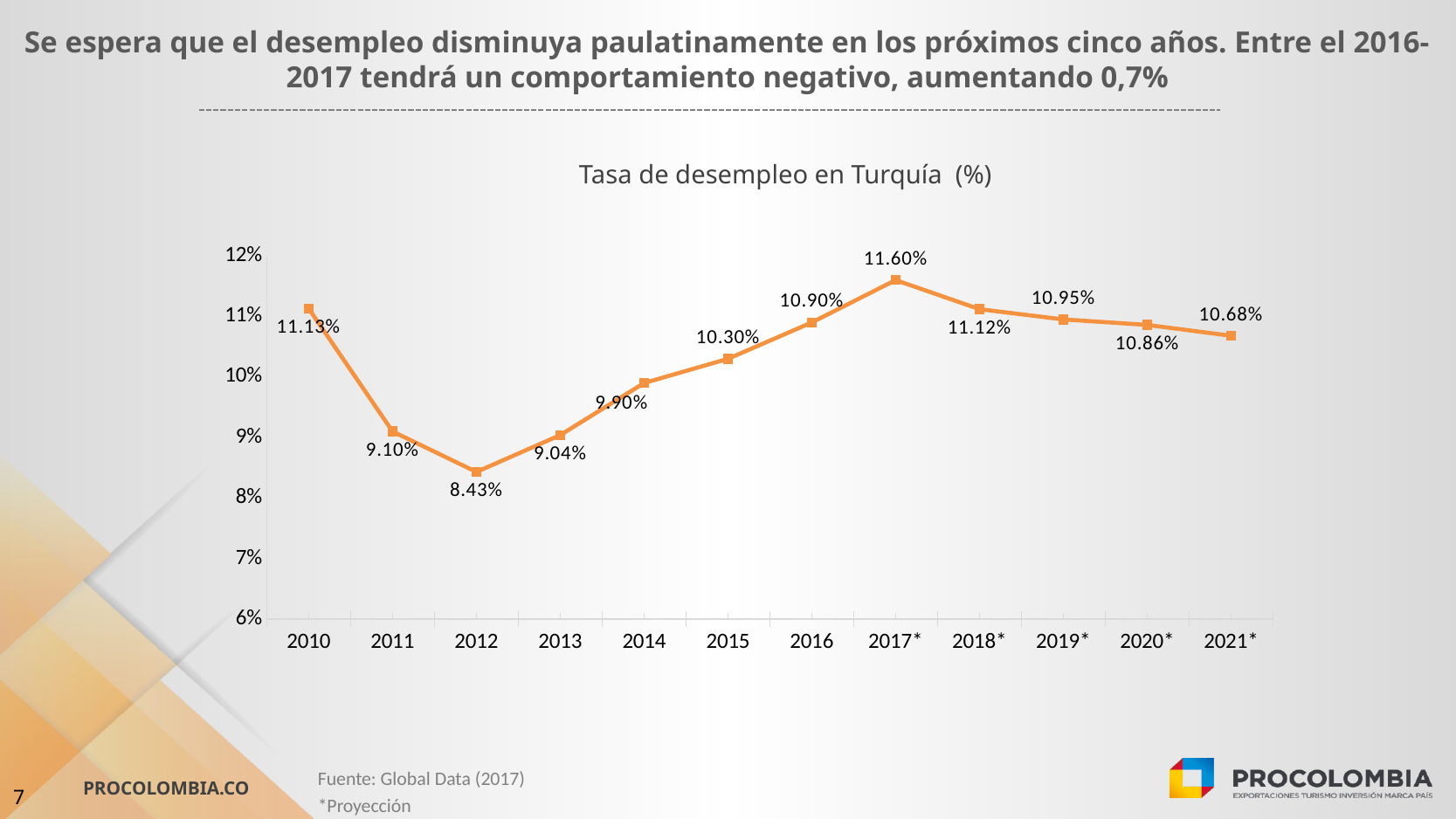
Does the unemployment rate rise or fall from 2017* to 2021*? Fall What is the title of the chart? Tasa de desempleo en Turquía (%) Is the value for 2014 greater or less than 10%? less What is the difference between the unemployment rate in 2017* and in 2016? 0.70% What is the unemployment rate shown for 2021*? 10.68% What is the unemployment rate shown for 2017*? 11.60% Which year has the lowest unemployment rate on the chart? 2012 What kind of chart is shown on the slide? Line chart Which is larger, the unemployment rate in 2010 or in 2018*? 2010 Which year has the highest unemployment rate on the chart? 2017* What is the unemployment rate shown for 2012? 8.43% How many years are plotted on the chart? 12